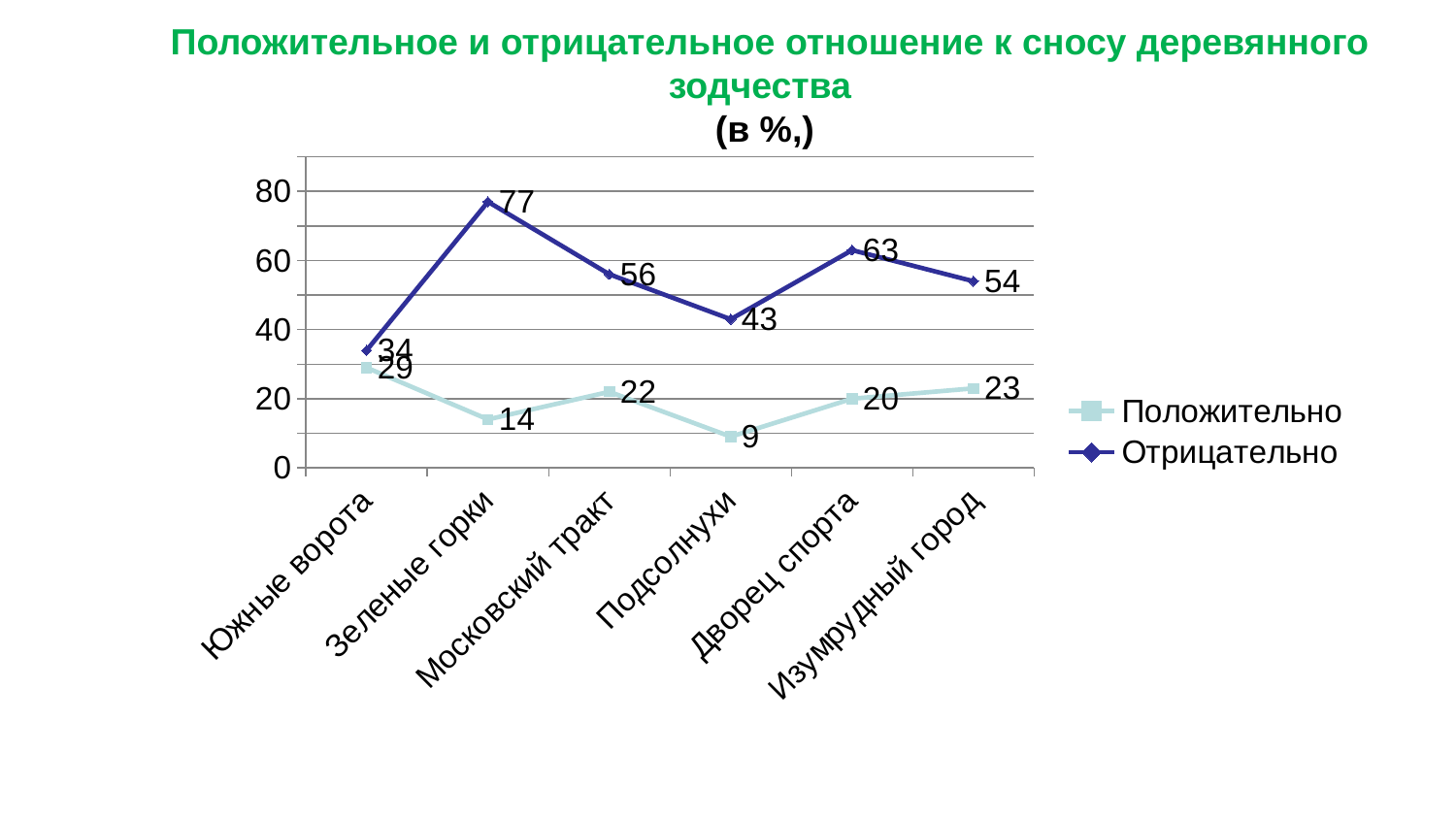
How many series does the legend list? 2 Which category has the highest value for Отрицательно? Зеленые горки What is the value for Отрицательно at Изумрудный город? 54 Which category has the lowest value for Положительно? Подсолнухи What is the value for Положительно at Подсолнухи? 9 What is the value for Положительно at Южные ворота? 29 What is the value for Отрицательно at Зеленые горки? 77 What is the value for Отрицательно at Подсолнухи? 43 What is the difference between Отрицательно and Положительно at Дворец спорта? 43 How many categories are shown on the x axis? 6 What kind of chart is this? line chart Which is larger at Московский тракт: Положительно or Отрицательно? Отрицательно